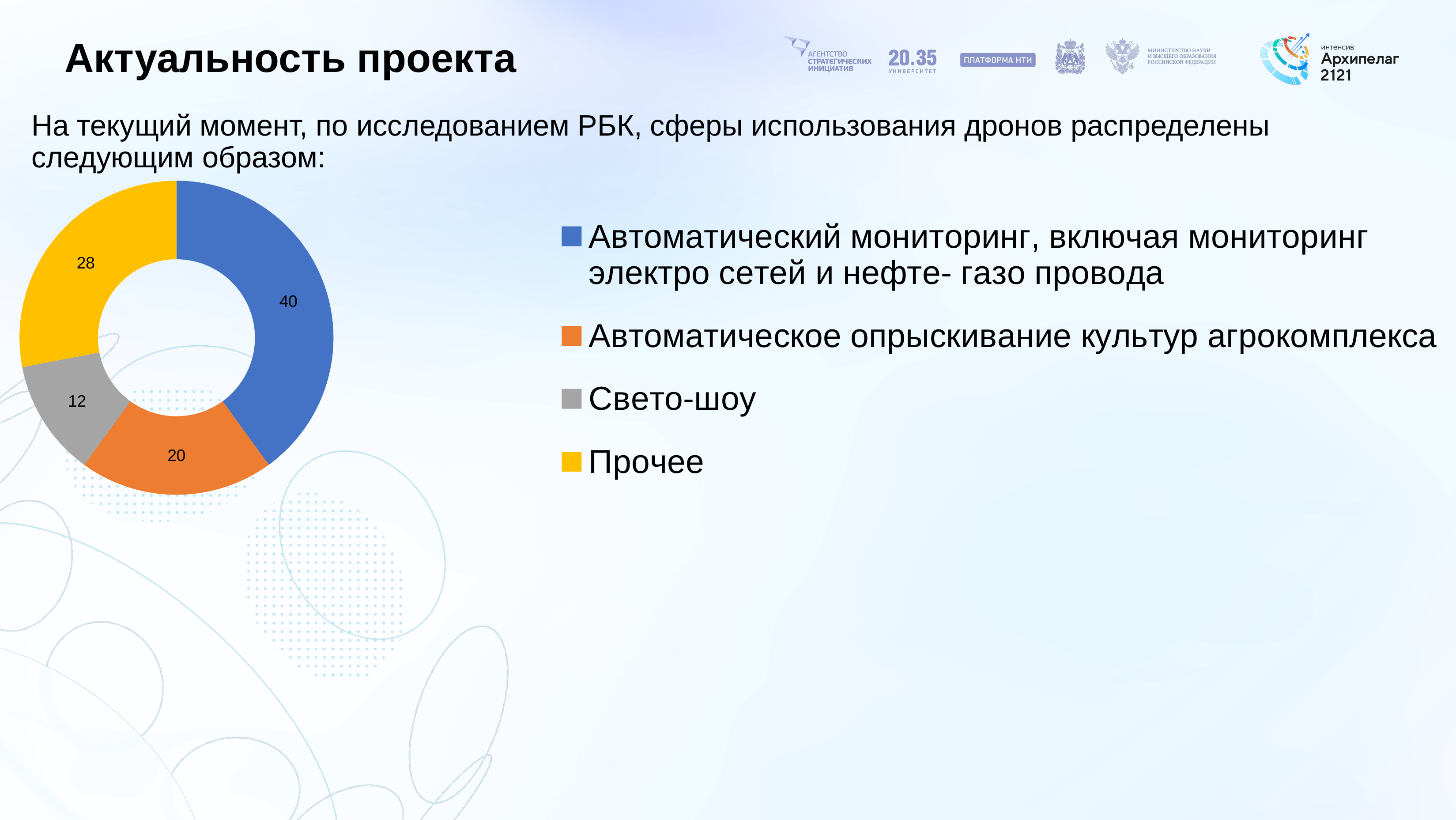
Which category has the largest slice in the chart? Автоматический мониторинг, включая мониторинг электро сетей и нефте- газо провода What colour is the "Прочее" slice in the chart? Yellow What share of the total do the "Автоматический мониторинг" slice's value of 40 represent? 40% What is the total of all the values shown in the chart? 100 What value is shown for the "Свето-шоу" slice? 12 Which is larger: the value for "Прочее" or the value for "Автоматическое опрыскивание культур агрокомплекса"? Прочее How many slices does the chart have? 4 What value is shown for the "Автоматическое опрыскивание культур агрокомплекса" slice? 20 Which category has the smallest slice in the chart? Свето-шоу What kind of chart is shown on the slide? Doughnut chart What value is shown for the "Прочее" slice? 28 What is the difference between the values for "Прочее" and "Свето-шоу"? 16